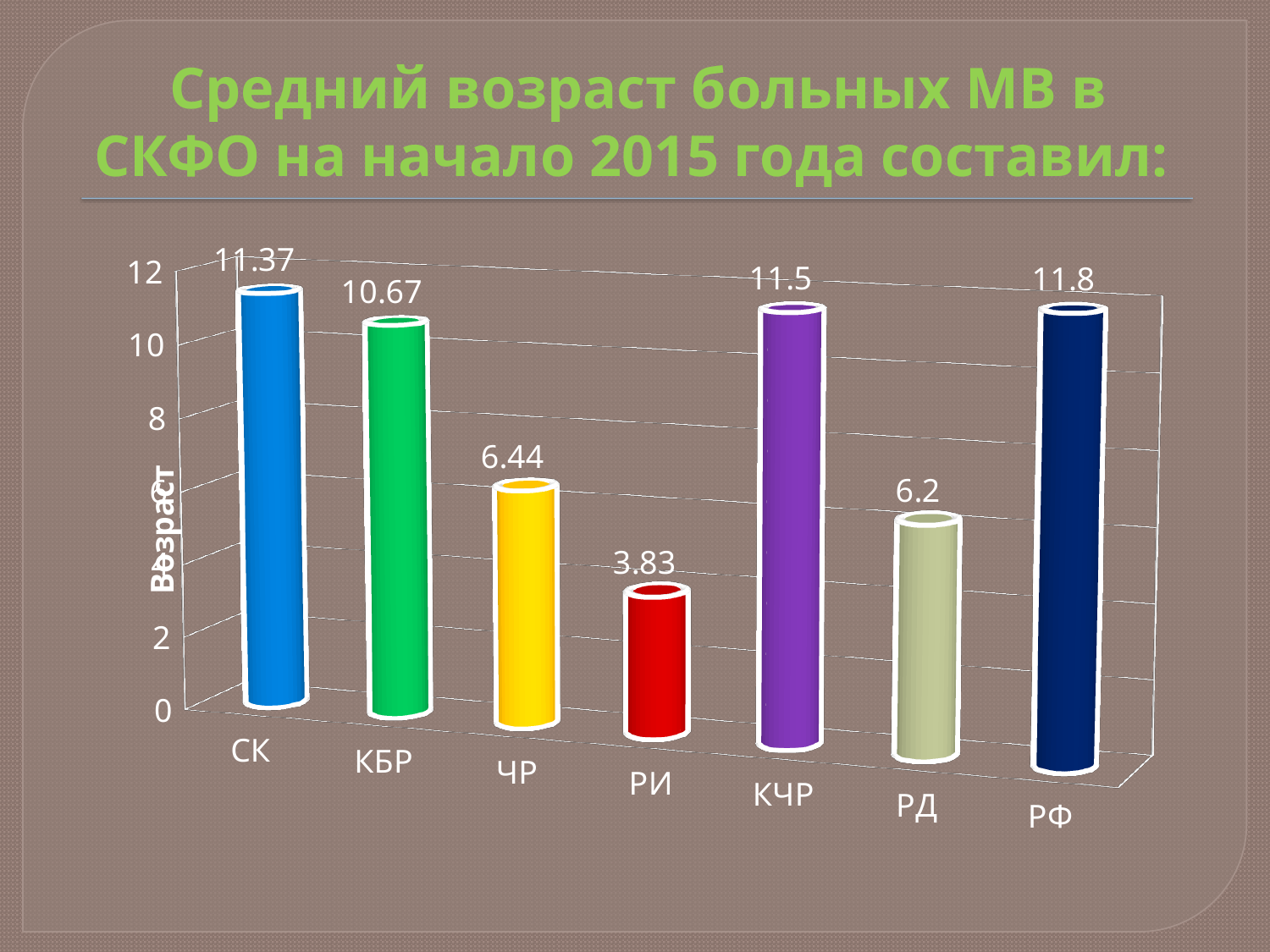
What is the label of the vertical axis? Возраст Is the value for КБР greater or less than 10? greater What is the value for СК? 11.37 Which category has the highest value? РФ Which is larger, the value for КБР or the value for ЧР? КБР What is the difference between the values for ЧР and РД? 0.24 What is the value for РИ? 3.83 What is the value for РД? 6.2 What is the value for КЧР? 11.5 What kind of chart is shown on the slide? bar chart How many categories are shown on the x axis? 7 Which category has the lowest value? РИ